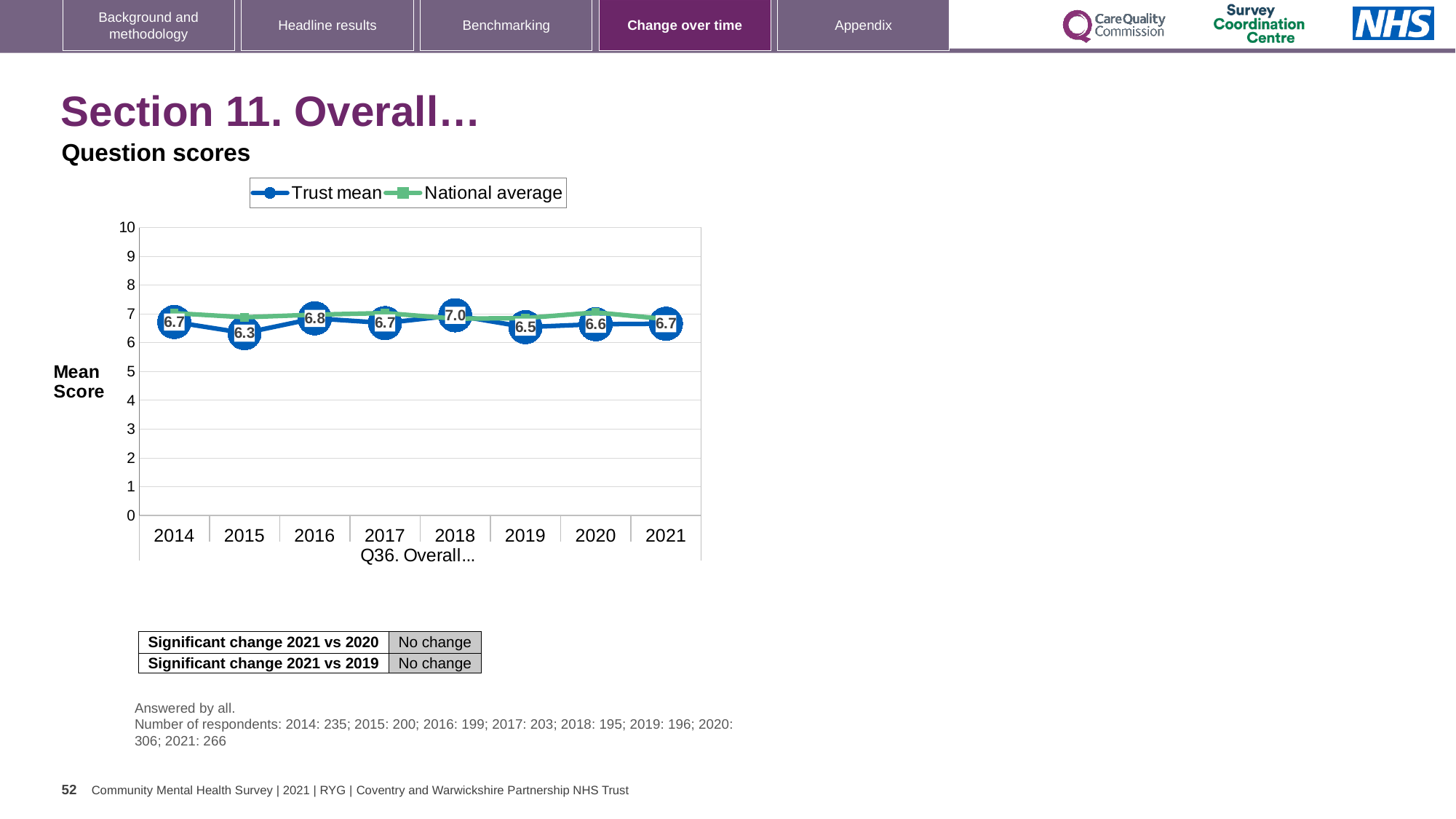
What is the Trust mean value for 2015? 6.3 What is the Trust mean value for 2018? 7.0 What is the difference between the Trust mean in 2018 and in 2015? 0.7 What kind of chart is shown? Line chart What is the Trust mean value for 2021? 6.7 Does the Trust mean rise or fall from 2014 to 2015? Fall How many series does the legend list? 2 In which year is the Trust mean lowest? 2015 Is the National average value for 2014 greater or less than 6? greater Which is larger, the Trust mean for 2016 or for 2019? 2016 In which year is the Trust mean highest? 2018 How many years are shown on the x axis? 8